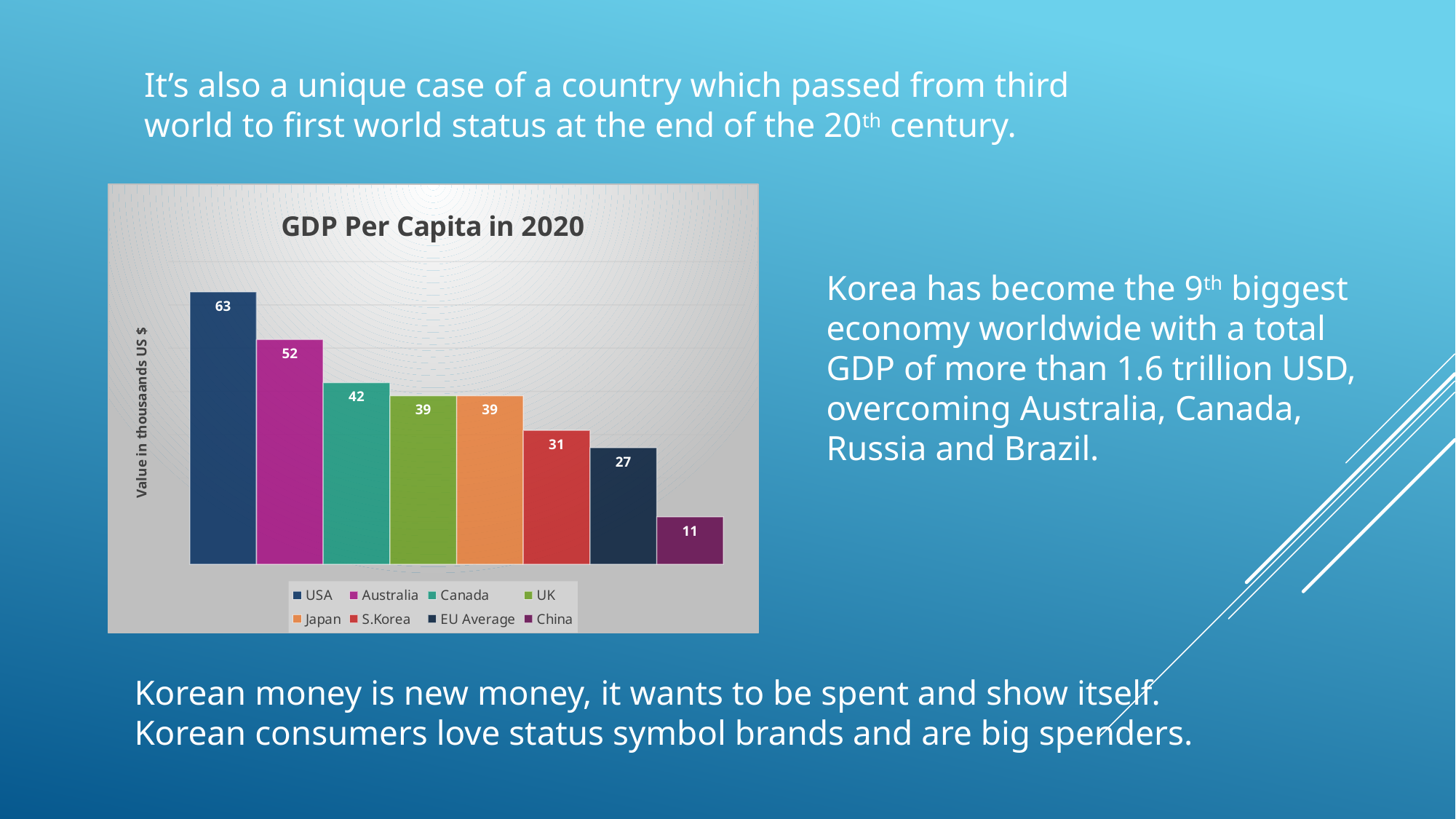
How many series does the legend list? 8 Which is larger, the value for Japan or the value for S.Korea? Japan Which country has the highest GDP per capita in the chart? USA What is the GDP per capita value shown for S.Korea? 31 What is the difference between the Canada value and the China value? 31 Which country has the lowest GDP per capita in the chart? China What is the label on the vertical axis of the chart? Value in thousaands US $ What is the difference between the USA value and the S.Korea value? 32 What is the value shown for the EU Average? 27 What is the GDP per capita value shown for Australia? 52 What kind of chart is shown on the slide? Bar chart What is the title of the chart? GDP Per Capita in 2020